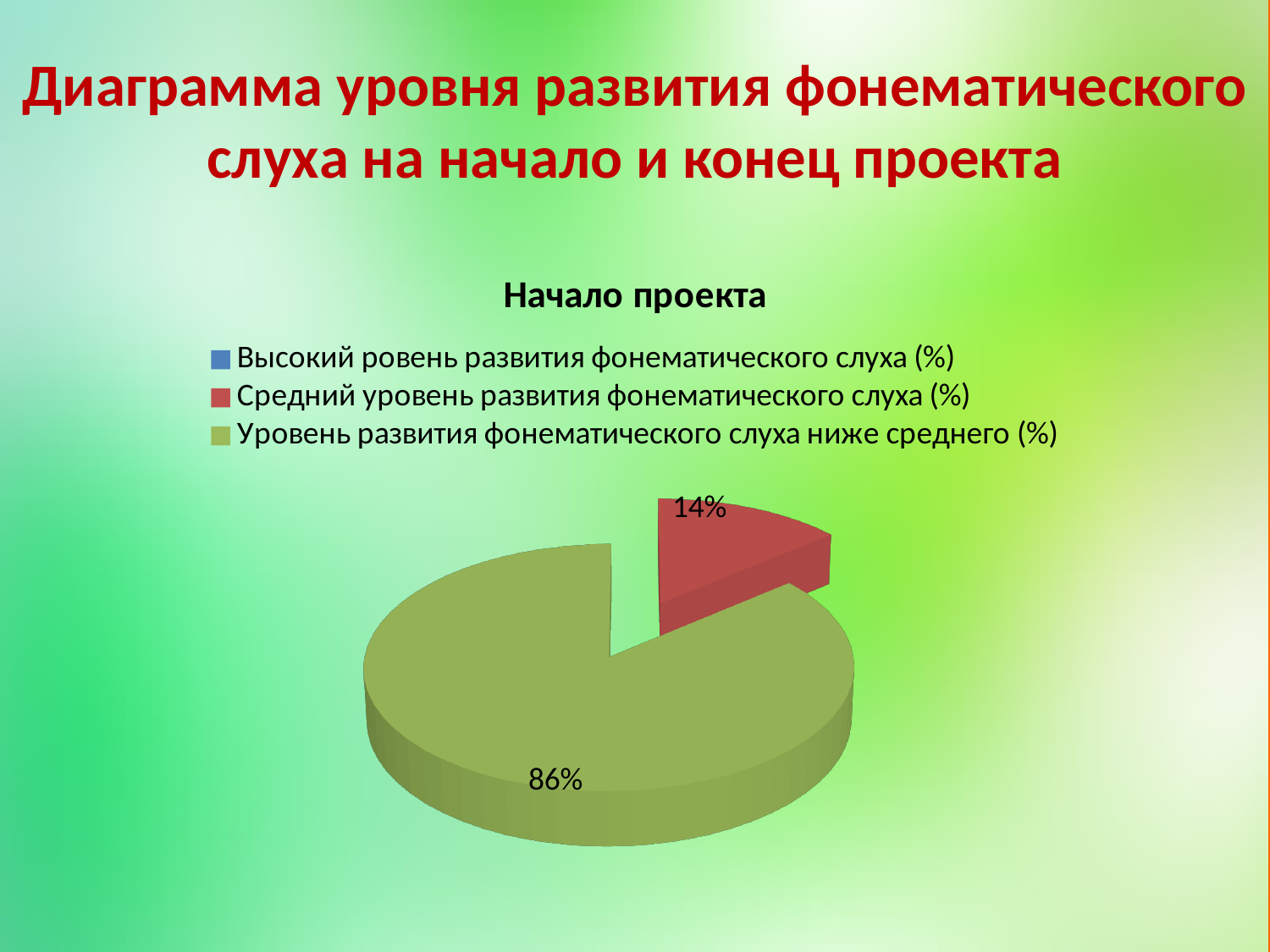
What is the chart's title? Начало проекта What type of chart is shown on the slide? pie chart What is the total of the two labelled slices? 100% What colour is the slice labelled 14%? red Which category has the largest slice of the pie? Уровень развития фонематического слуха ниже среднего (%) What is the difference between the 86% slice and the 14% slice? 72% What percentage is shown for 'Средний уровень развития фонематического слуха (%)'? 14% What percentage is shown for 'Уровень развития фонематического слуха ниже среднего (%)'? 86% Which of the two labelled slices is the smaller one? Средний уровень развития фонематического слуха (%) Which is larger: the slice for 'Средний уровень' or the slice for 'ниже среднего'? ниже среднего How many slices have a percentage label on the pie? 2 How many entries does the legend list? 3